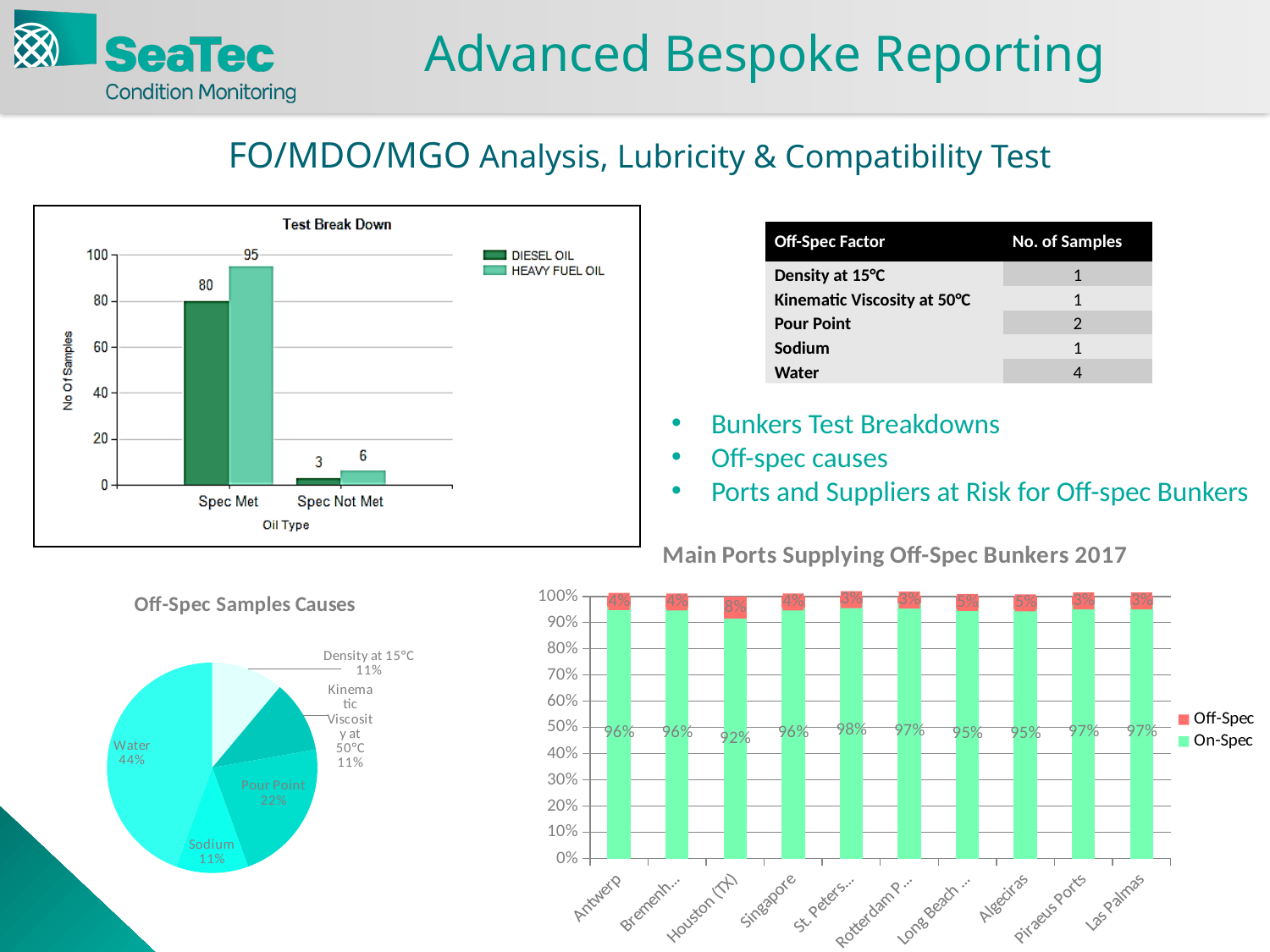
In the Main Ports Supplying Off-Spec Bunkers 2017 chart, which port has the highest Off-Spec percentage? Houston (TX) In the Off-Spec Samples Causes chart, what percentage is shown for Pour Point? 22% In the Main Ports Supplying Off-Spec Bunkers 2017 chart, what is the On-Spec percentage for Houston (TX)? 92% In the Off-Spec Samples Causes chart, which cause has the largest slice? Water In the Test Break Down chart, what is the value for Heavy Fuel Oil in the Spec Not Met category? 6 In the Test Break Down chart, what is the difference between the Heavy Fuel Oil and Diesel Oil values for Spec Met? 15 In the Test Break Down chart, how many series does the legend list? 2 What kind of chart is the Test Break Down chart? Bar chart How many slices does the Off-Spec Samples Causes pie chart have? 5 In the Off-Spec Samples Causes chart, what share of the pie does Water have? 44% In the Test Break Down chart, what is the value for Diesel Oil in the Spec Met category? 80 How many ports are shown on the x axis of the Main Ports Supplying Off-Spec Bunkers 2017 chart? 10